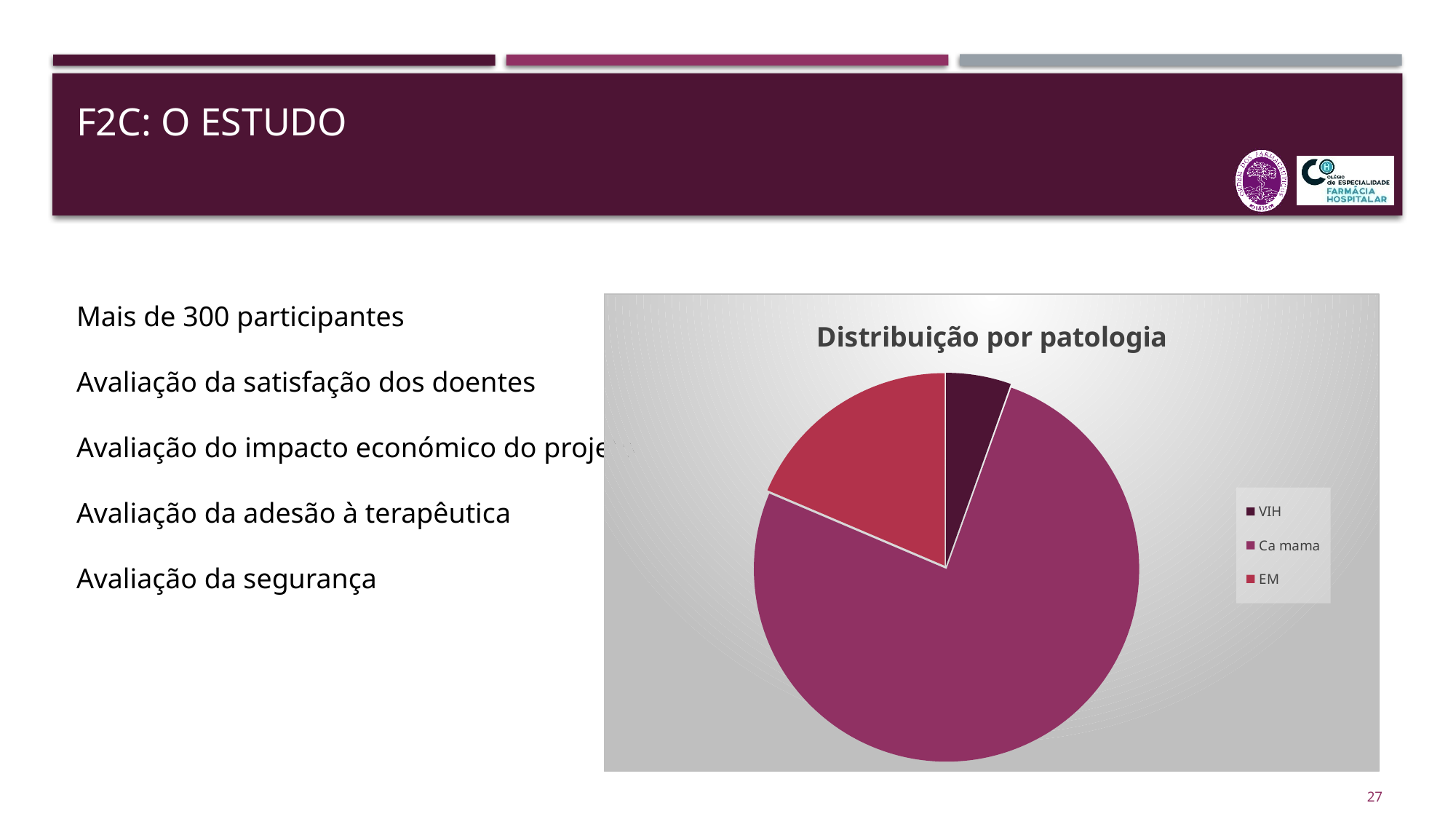
Which category has the largest slice of the pie chart? Ca mama Which category is shown in the darkest colour in the pie chart? VIH What kind of chart is shown on the slide? pie chart Does the Ca mama slice take up more or less than half of the pie? more How many entries does the legend of the pie chart list? 3 What is the title of the chart? Distribuição por patologia Which slice is larger, Ca mama or EM? Ca mama Which slice is larger, EM or VIH? EM Which category has the smallest slice of the pie chart? VIH How many slices does the pie chart have? 3